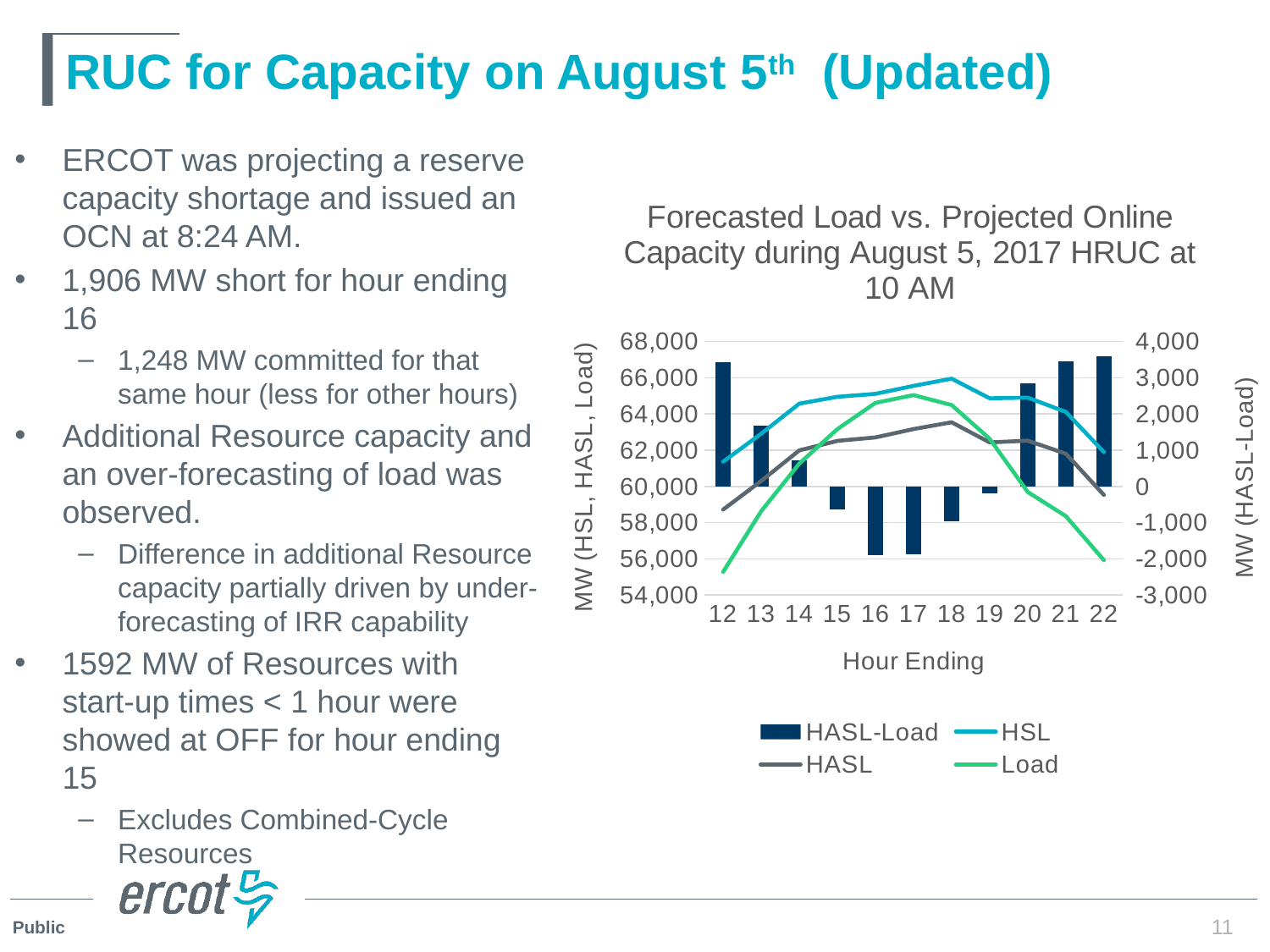
What is the title of the chart? Forecasted Load vs. Projected Online Capacity during August 5, 2017 HRUC at 10 AM At hour ending 16, which is larger, HASL or Load? Load How many hour-ending categories are shown on the x axis of the chart? 11 What kind of chart is shown on the slide? A combination bar and line chart Is the HSL value for hour ending 18 greater or less than 64,000? greater Is the Load value for hour ending 12 greater or less than 56,000? less Is the HASL-Load value for hour ending 22 greater or less than 3,000? greater At hour ending 12, which is larger, HSL or Load? HSL Which series in the chart is plotted as bars? HASL-Load Does the Load line rise or fall from hour ending 12 to hour ending 17? rise How many series does the chart legend list? 4